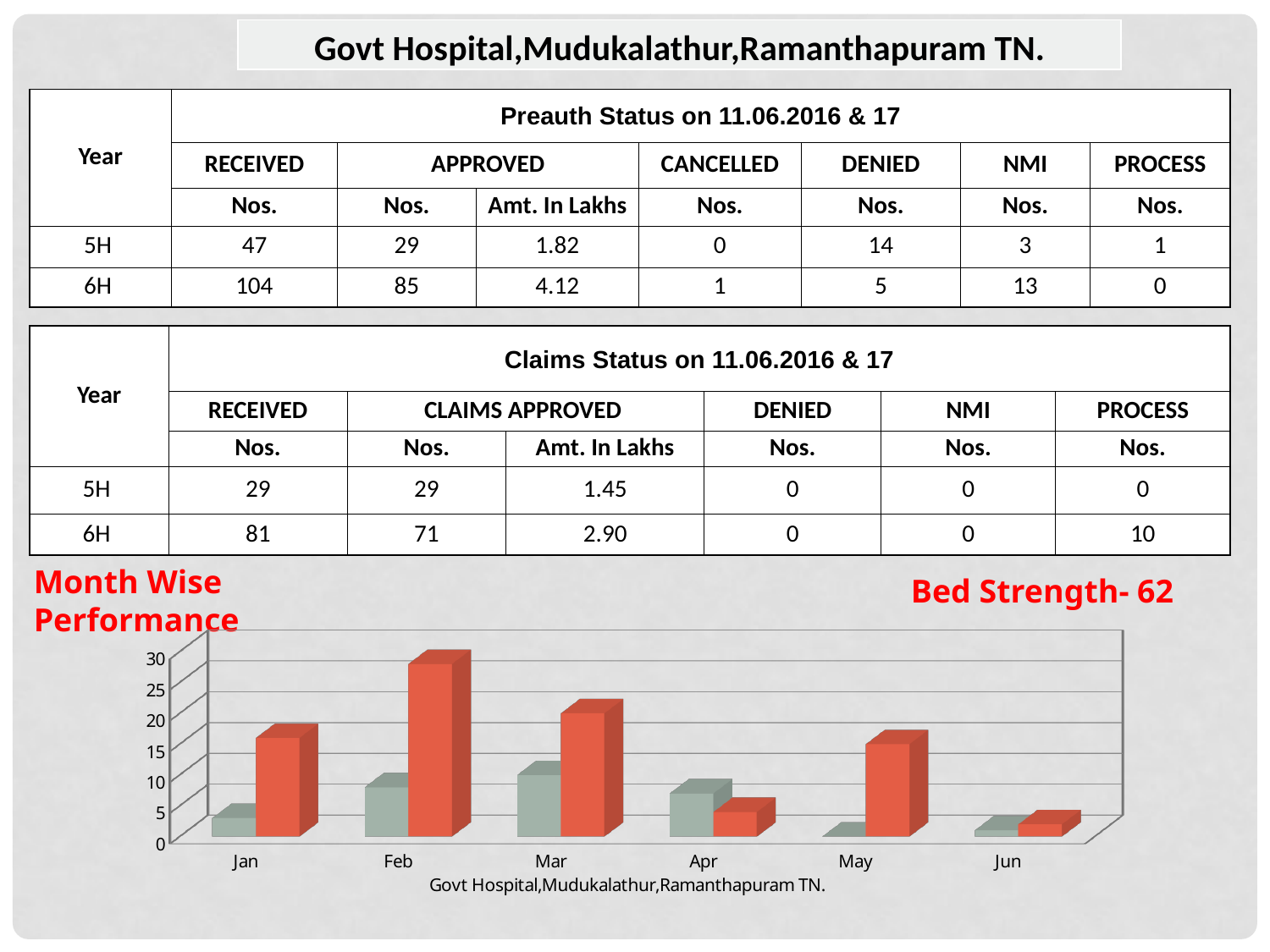
In the Month Wise Performance chart, is the red bar for May greater or less than 10? greater How many months are shown on the x axis of the Month Wise Performance chart? 6 In the Month Wise Performance chart, which month has the tallest red bar? Feb In the Month Wise Performance chart, is the grey bar for Mar greater or less than 5? greater In the Month Wise Performance chart, is the red bar for Feb greater or less than 25? greater In the Month Wise Performance chart, which month has the shortest red bar? Jun In the Month Wise Performance chart, which is larger for Apr: the grey bar or the red bar? the grey bar What text appears below the x axis of the Month Wise Performance chart? Govt Hospital,Mudukalathur,Ramanthapuram TN. What kind of chart is shown under the 'Month Wise Performance' heading? bar chart In the Month Wise Performance chart, which is larger: the red bar for Feb or the red bar for Apr? Feb